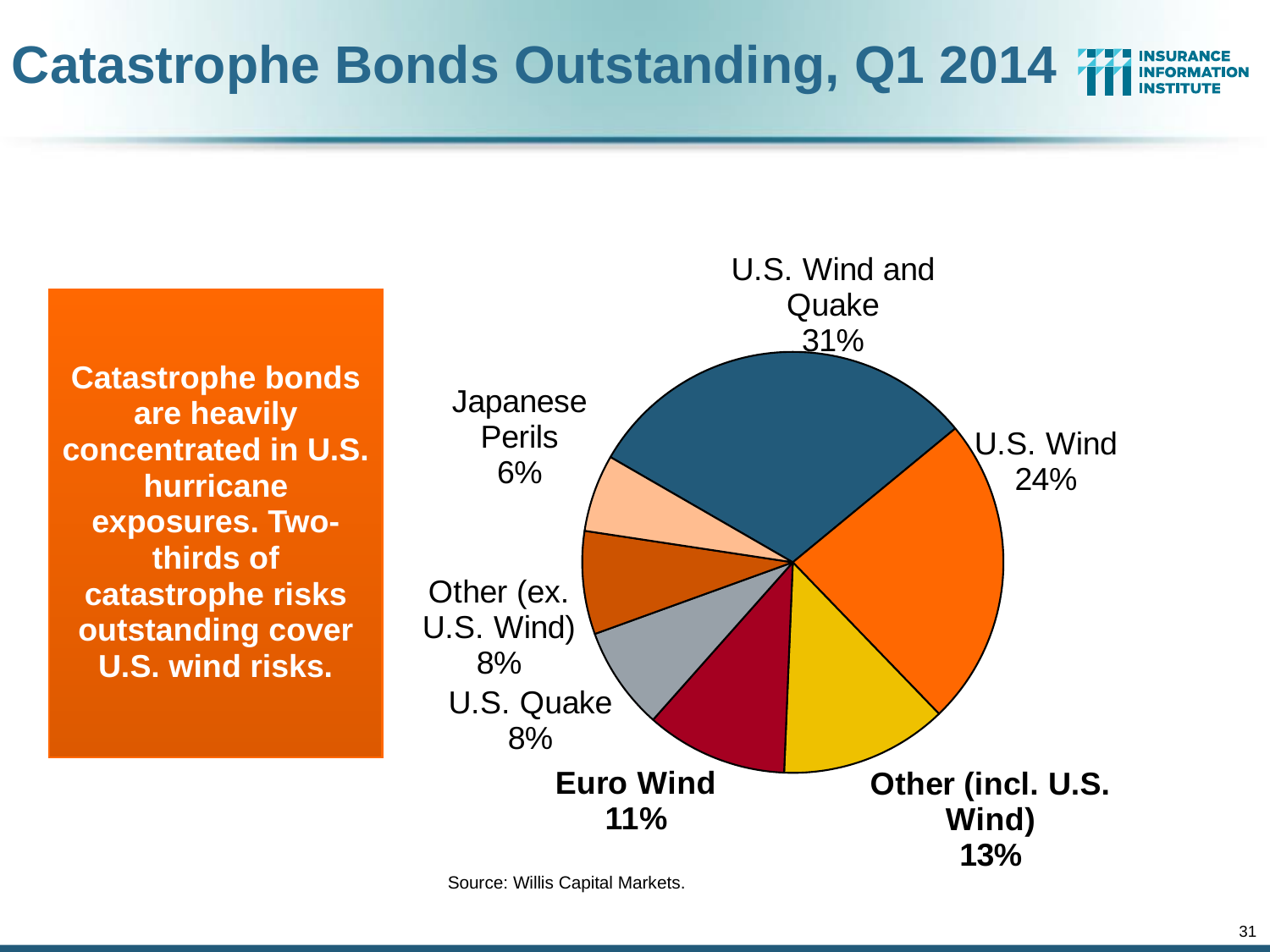
What share of catastrophe bonds outstanding is for Other (incl. U.S. Wind)? 13% How many categories are shown in the pie chart? 7 What share of catastrophe bonds outstanding is for Euro Wind? 11% What is the source cited for the chart? Willis Capital Markets Which has a larger share, Euro Wind or Other (incl. U.S. Wind)? Other (incl. U.S. Wind) Which category has the smallest share of catastrophe bonds outstanding? Japanese Perils What share of catastrophe bonds outstanding is for U.S. Wind and Quake? 31% What share of catastrophe bonds outstanding is for Japanese Perils? 6% What share of catastrophe bonds outstanding is for U.S. Wind? 24% What kind of chart is shown on the slide? Pie chart Which category has the largest share of catastrophe bonds outstanding? U.S. Wind and Quake What is the difference in percentage points between the U.S. Wind and Quake share and the U.S. Wind share? 7 percentage points